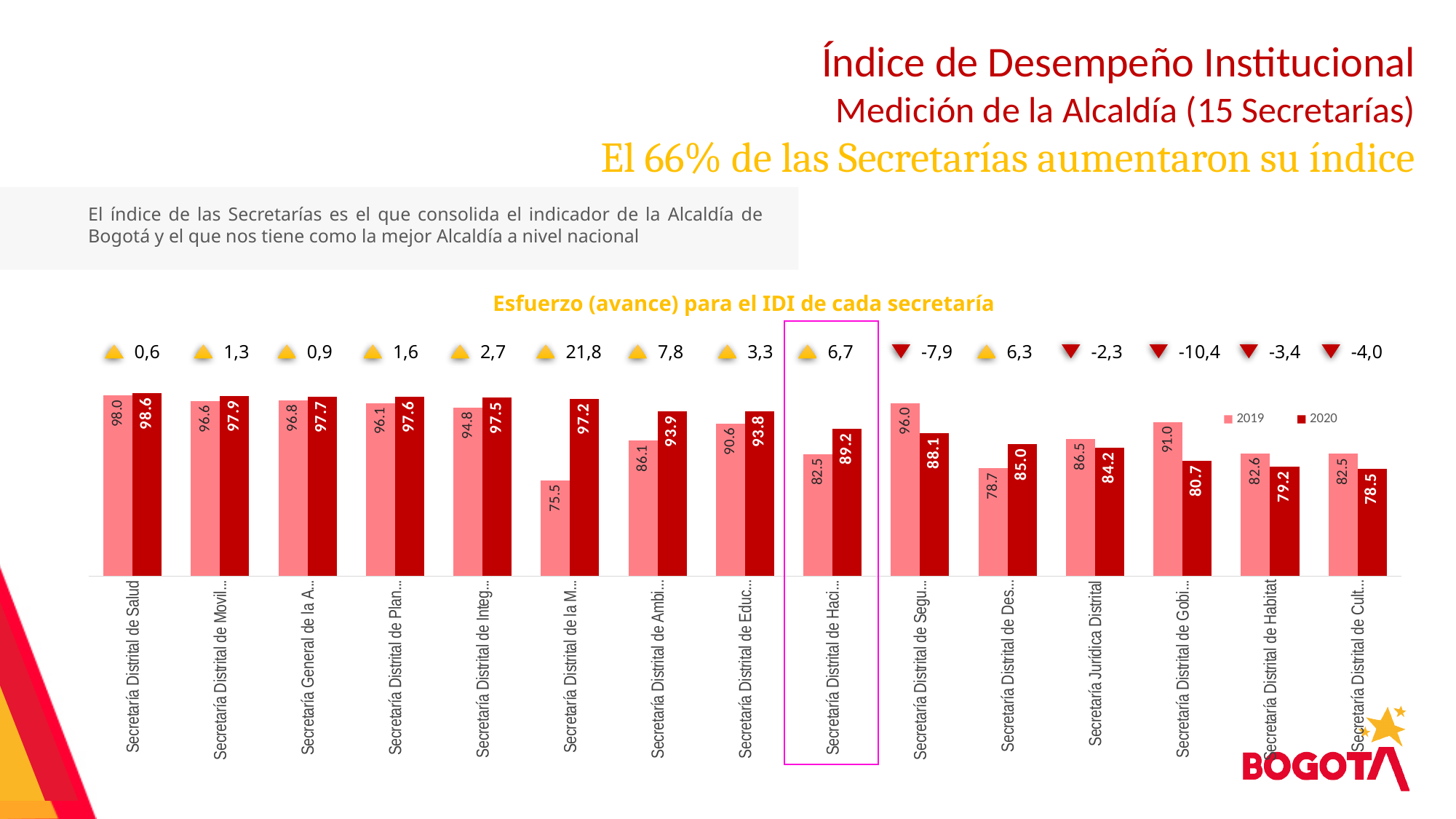
What is the lowest 2020 value shown in the chart? 78.5 What is the lowest 2019 value shown in the chart? 75.5 What is the 2020 value for Secretaría Distrital de Habitat? 79.2 How many series does the chart legend list? 2 What is the difference between the 2019 and 2020 values for Secretaría Distrital de Habitat? 3.4 Which secretaría has the highest 2020 value? Secretaría Distrital de Salud What type of chart is shown on the slide? Bar chart How many secretarías (categories) are shown in the chart? 15 For Secretaría Jurídica Distrital, which year has the larger value, 2019 or 2020? 2019 By how much did the value for Secretaría Distrital de Salud increase from 2019 to 2020? 0.6 What is the 2020 value for Secretaría Distrital de Salud? 98.6 What is the 2019 value for Secretaría Jurídica Distrital? 86.5